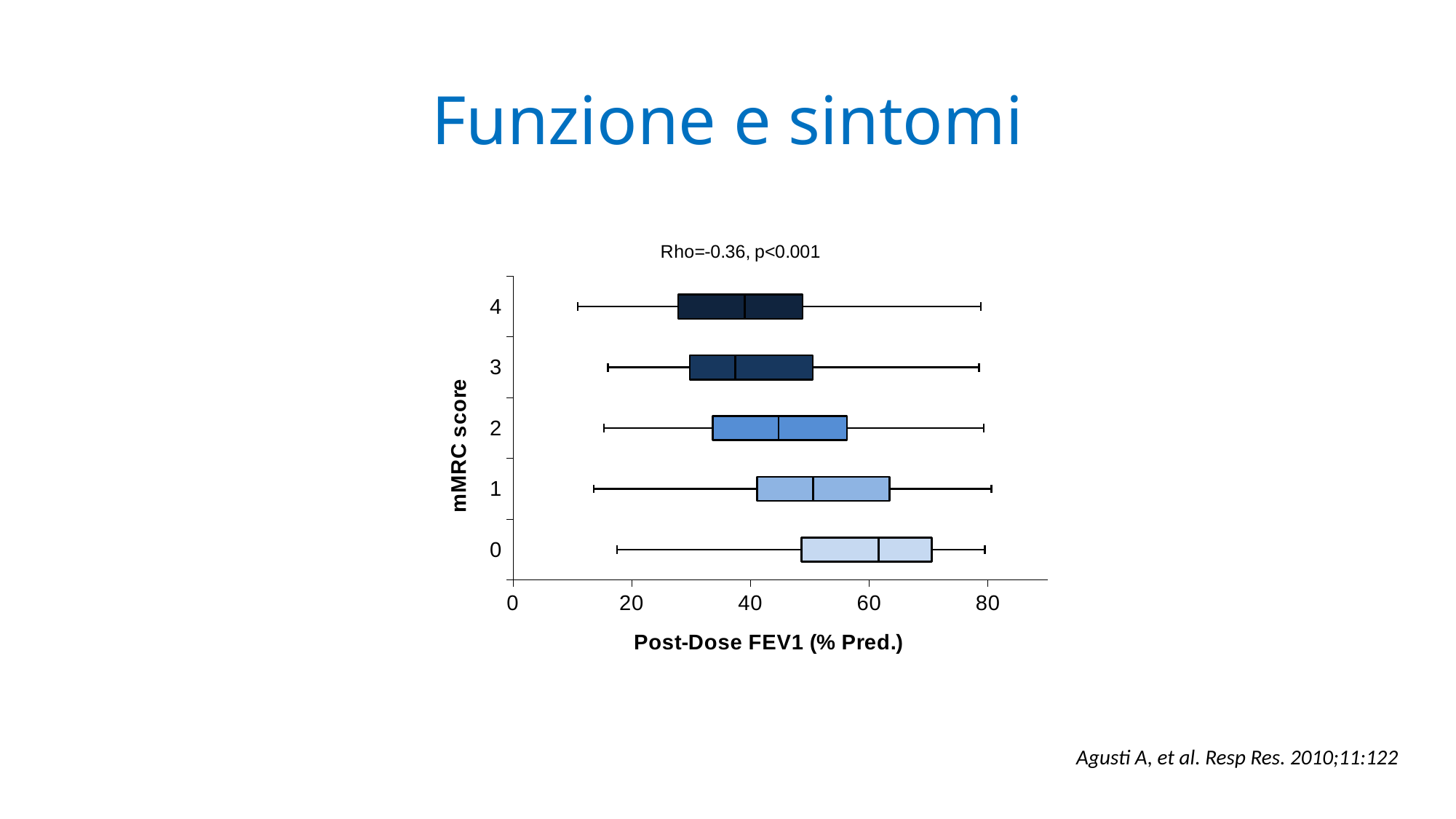
What kind of chart is shown on the slide? Box plot Which mMRC score has the highest median Post-Dose FEV1 (% Pred.)? 0 Is the median Post-Dose FEV1 for mMRC score 0 greater or less than 40? greater Is the median Post-Dose FEV1 for mMRC score 3 greater or less than 60? less As the mMRC score increases from 0 to 4, does the median Post-Dose FEV1 rise or fall? fall Is the median Post-Dose FEV1 for mMRC score 4 greater or less than 60? less Which has the larger median Post-Dose FEV1: mMRC score 1 or mMRC score 3? mMRC score 1 What correlation statistic is printed above the chart? Rho=-0.36, p<0.001 How many mMRC score categories are plotted on the chart? 5 What is the label of the horizontal axis of the chart? Post-Dose FEV1 (% Pred.) Which has the larger median Post-Dose FEV1: mMRC score 0 or mMRC score 4? mMRC score 0